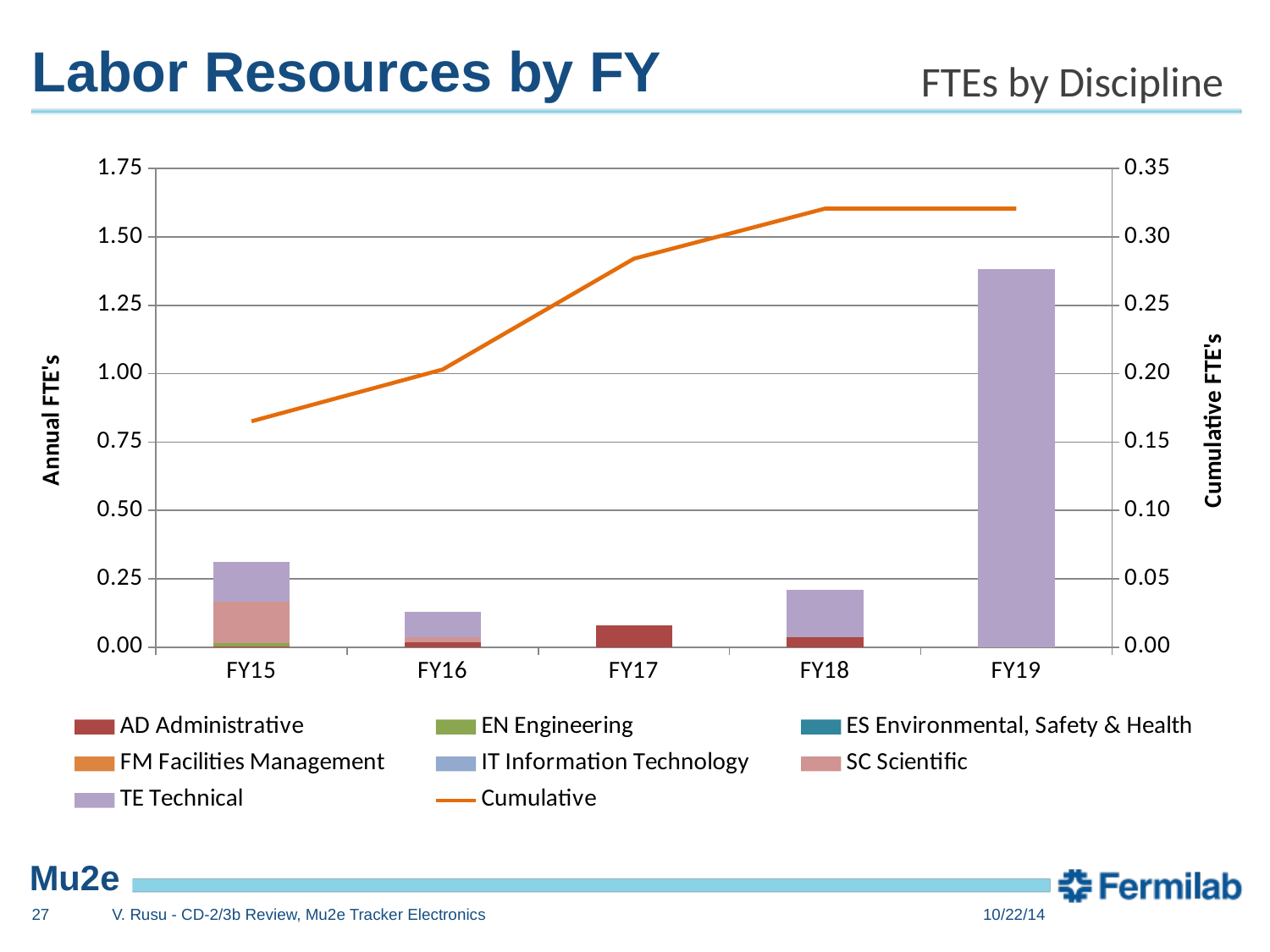
What kind of chart is shown on the slide? Stacked bar chart with a line Is the Cumulative line value at FY19 greater or less than 0.30 on the right axis? greater Which fiscal year has the tallest stacked bar? FY19 Which fiscal year has the shortest stacked bar? FY17 How many fiscal years are shown on the x axis of the chart? 5 Is the total annual FTE bar for FY15 greater or less than 0.25? greater Is the total annual FTE bar for FY19 greater or less than 1.25? greater Does the Cumulative line rise or fall from FY15 to FY19? rise Which has the taller stacked bar, FY15 or FY16? FY15 How many series does the chart legend list? 8 What is the title of the left vertical axis? Annual FTE's